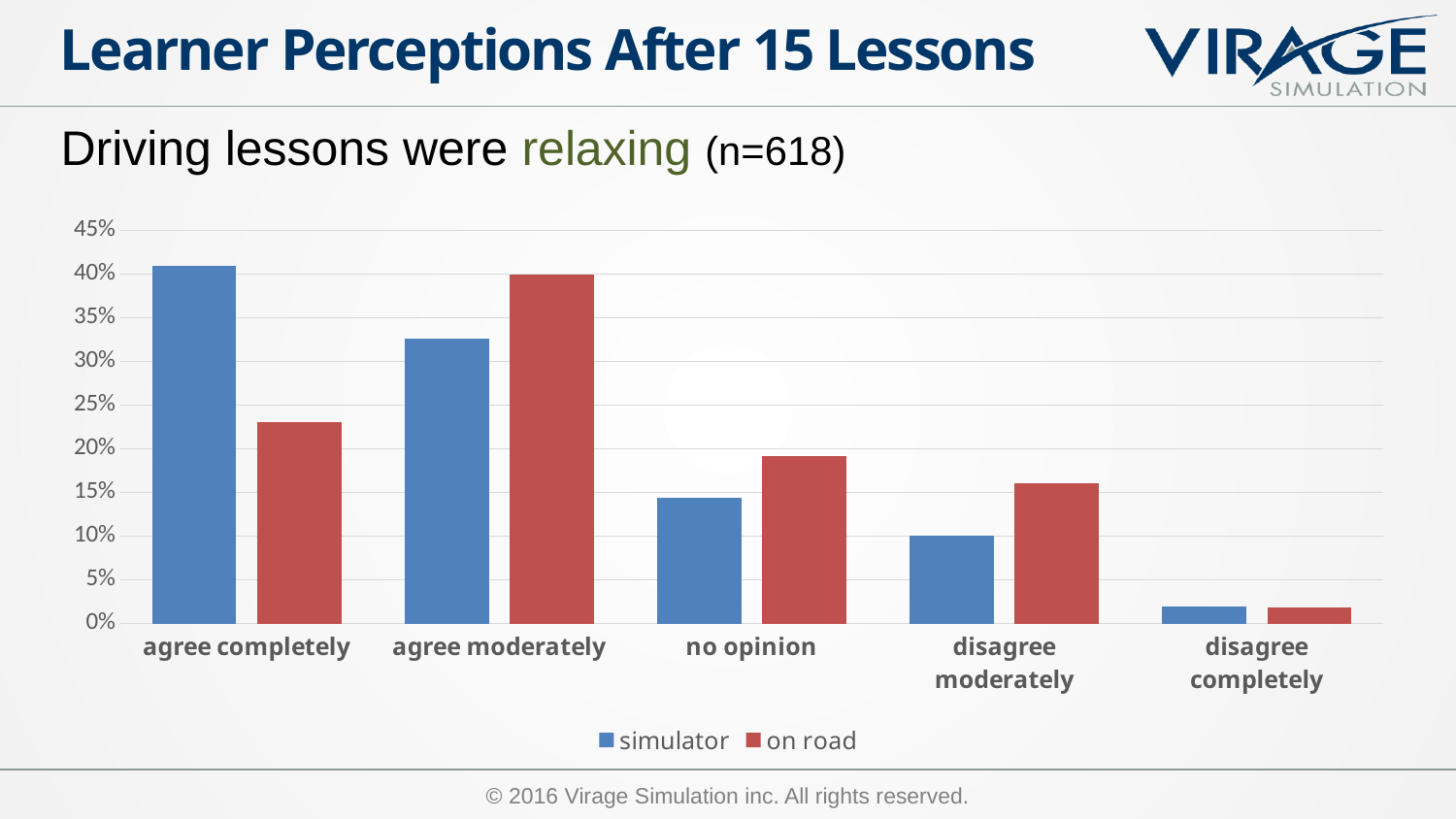
Is the on road value for 'agree completely' greater or less than 20%? greater For 'agree completely', which series has the larger value, simulator or on road? simulator What kind of chart is shown on the slide? bar chart How many series does the legend list? 2 What colour are the bars for the on road series? red Which category has the highest value for the simulator series? agree completely Which category has the highest value for the on road series? agree moderately Which category has the lowest value for the simulator series? disagree completely Do the simulator values rise or fall moving from 'agree completely' to 'disagree completely' along the x axis? fall Is the simulator value for 'agree completely' greater or less than 35%? greater How many response categories are shown on the x axis? 5 For 'agree moderately', which series has the larger value, simulator or on road? on road